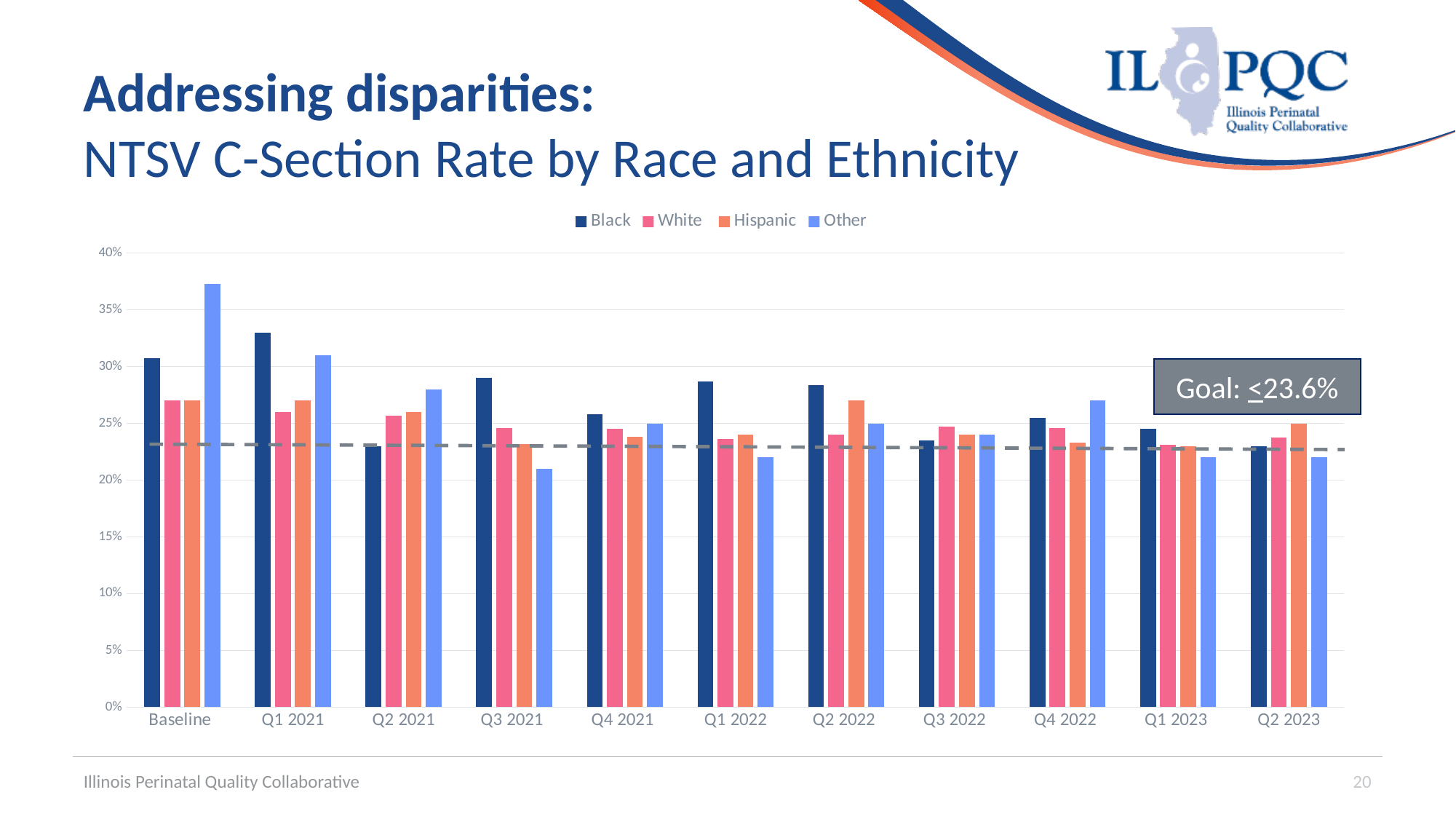
Is the value for Other at Q3 2021 greater or less than 25%? less How many time-period categories are shown on the x axis? 11 How many series does the legend list? 4 At Q3 2021, which is larger, the value for Black or the value for Other? Black Which series has the lowest bar at Q2 2021? Black Is the value for Black at Q1 2021 greater or less than 30%? greater What goal value is shown in the box on the chart? ≤23.6% Which series has the highest bar at Baseline? Other Does the Black series rise or fall overall from Baseline to Q2 2023? fall What kind of chart is shown on the slide? bar chart Is the value for Other at Baseline greater or less than 35%? greater Which colour represents the Hispanic series in the legend? orange